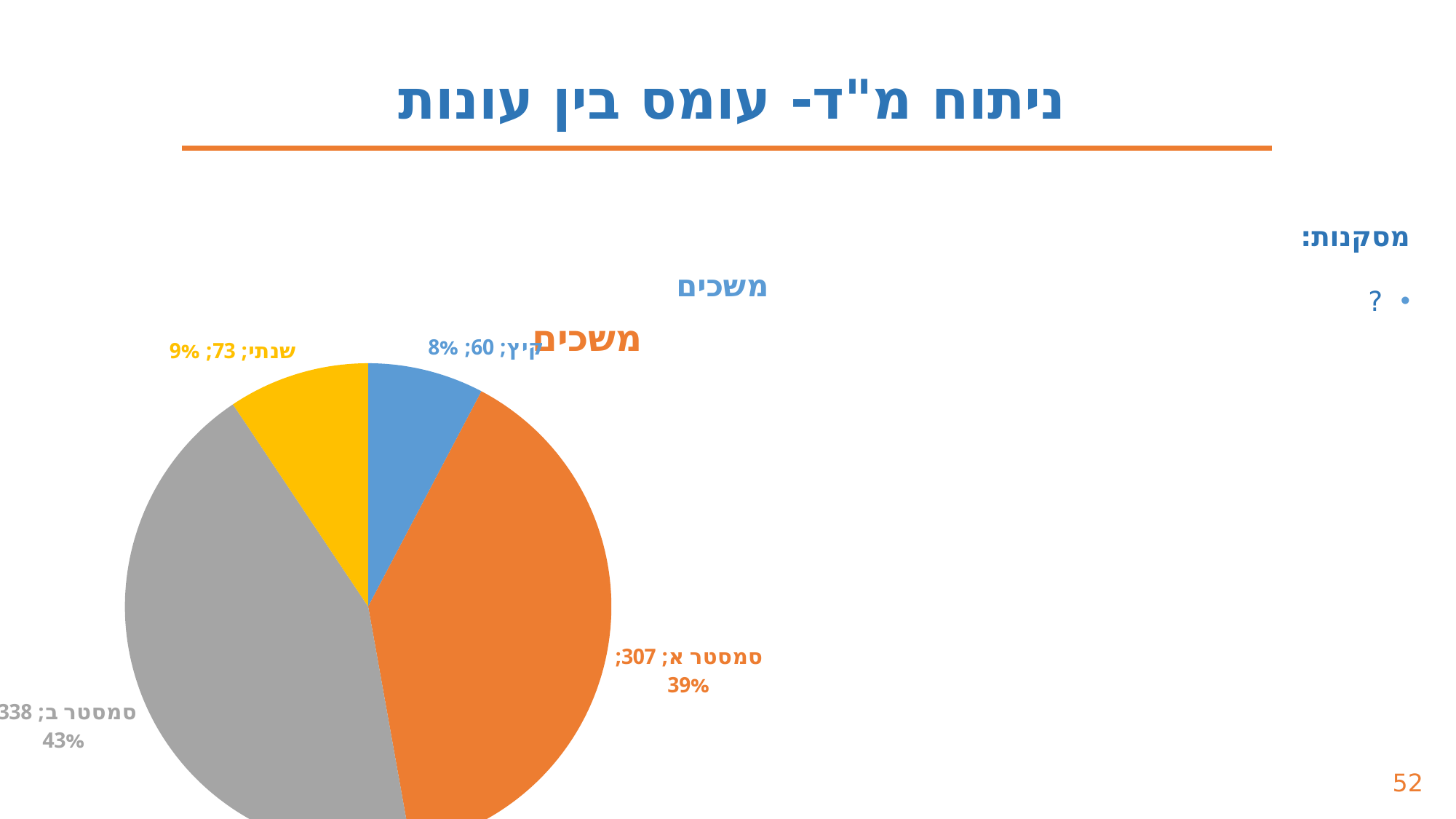
What is the value for סמסטר א in the pie chart? 307 What is the title of the pie chart? משכים What share of the pie does קיץ represent? 8% What kind of chart is shown on the slide? pie chart How many slices does the pie chart have? 4 What is the value for סמסטר ב in the pie chart? 338 What is the difference between the values for סמסטר ב and סמסטר א? 31 Which category has the smallest slice in the pie chart? קיץ Which category has the largest slice in the pie chart? סמסטר ב What is the value for שנתי in the pie chart? 73 What is the value for קיץ in the pie chart? 60 What share of the pie does סמסטר ב represent? 43%